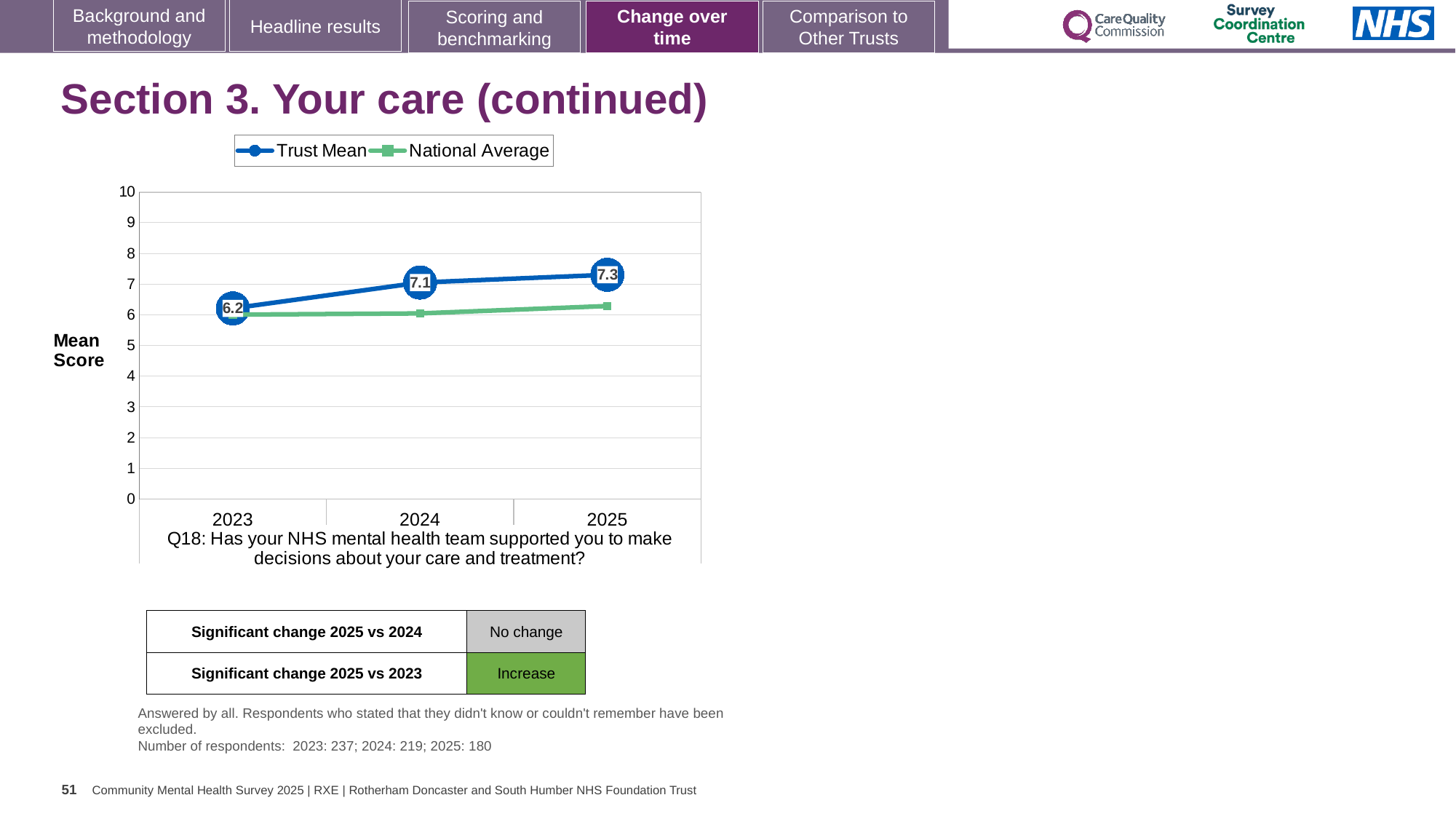
What is the Trust Mean score for 2024? 7.1 How many series does the legend list? 2 What is the Trust Mean score for 2025? 7.3 What is the difference between the Trust Mean score in 2024 and in 2023? 0.9 In 2025, which is higher: the Trust Mean or the National Average? Trust Mean What kind of chart is shown on the slide? line chart In which year is the Trust Mean score lowest? 2023 What is the Trust Mean score for 2023? 6.2 Is the National Average value for 2025 greater or less than 7? less How many years are shown on the x axis? 3 What is the difference between the Trust Mean score in 2025 and in 2023? 1.1 In which year is the Trust Mean score highest? 2025